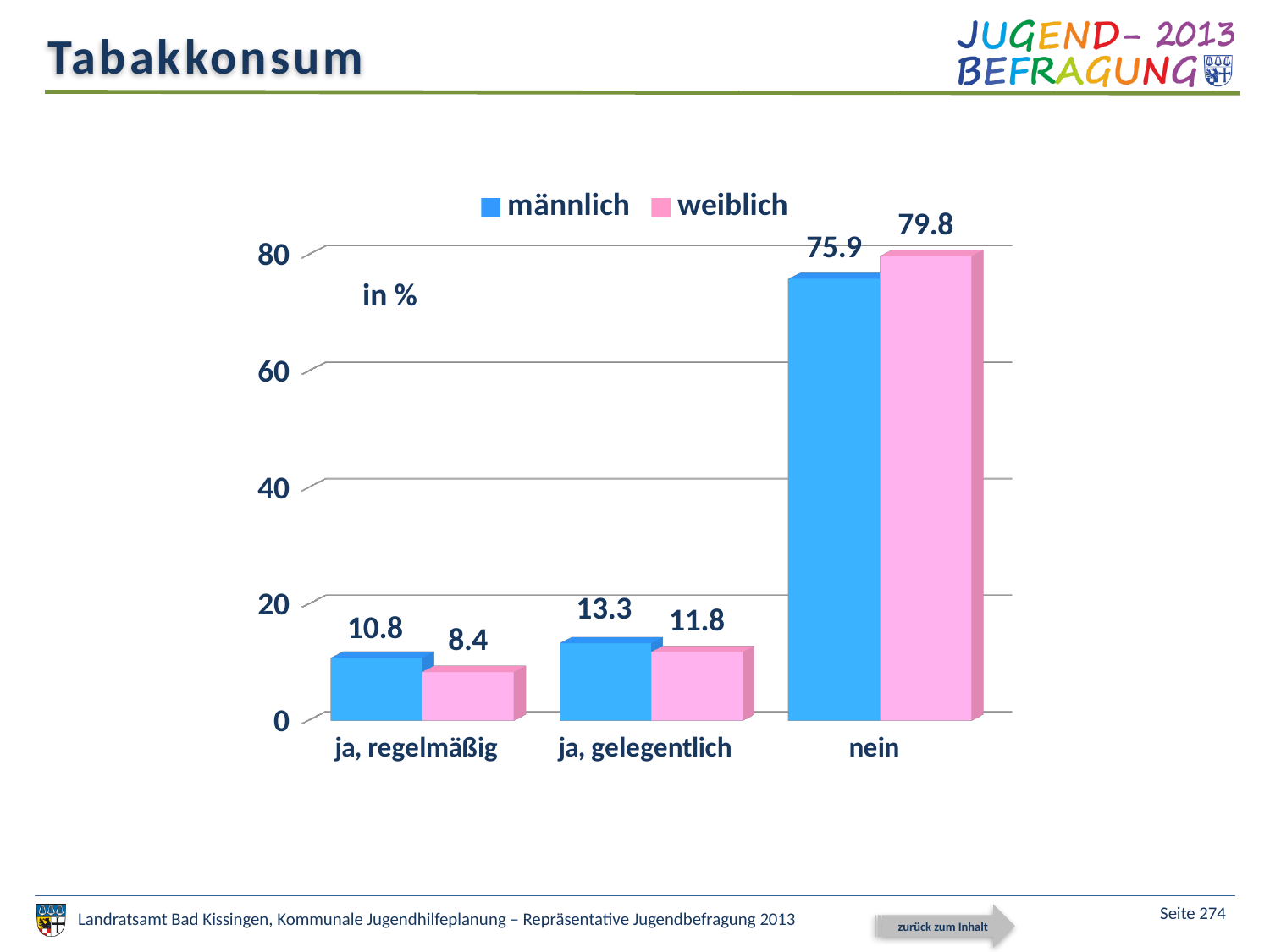
Which is larger in the category "ja, gelegentlich": the männlich value or the weiblich value? männlich What is the difference between the weiblich and männlich values in the category "nein"? 3.9 What is the value for weiblich in the category "ja, regelmäßig"? 8.4 What unit is indicated on the chart? in % How many series does the legend list? 2 How many categories are shown on the x axis? 3 What is the value for männlich in the category "ja, gelegentlich"? 13.3 Is the value for weiblich in the category "nein" greater or less than 60? greater What is the value for männlich in the category "nein"? 75.9 Which category has the highest value for weiblich? nein What kind of chart is shown on the slide? bar chart Which category has the lowest value for männlich? ja, regelmäßig